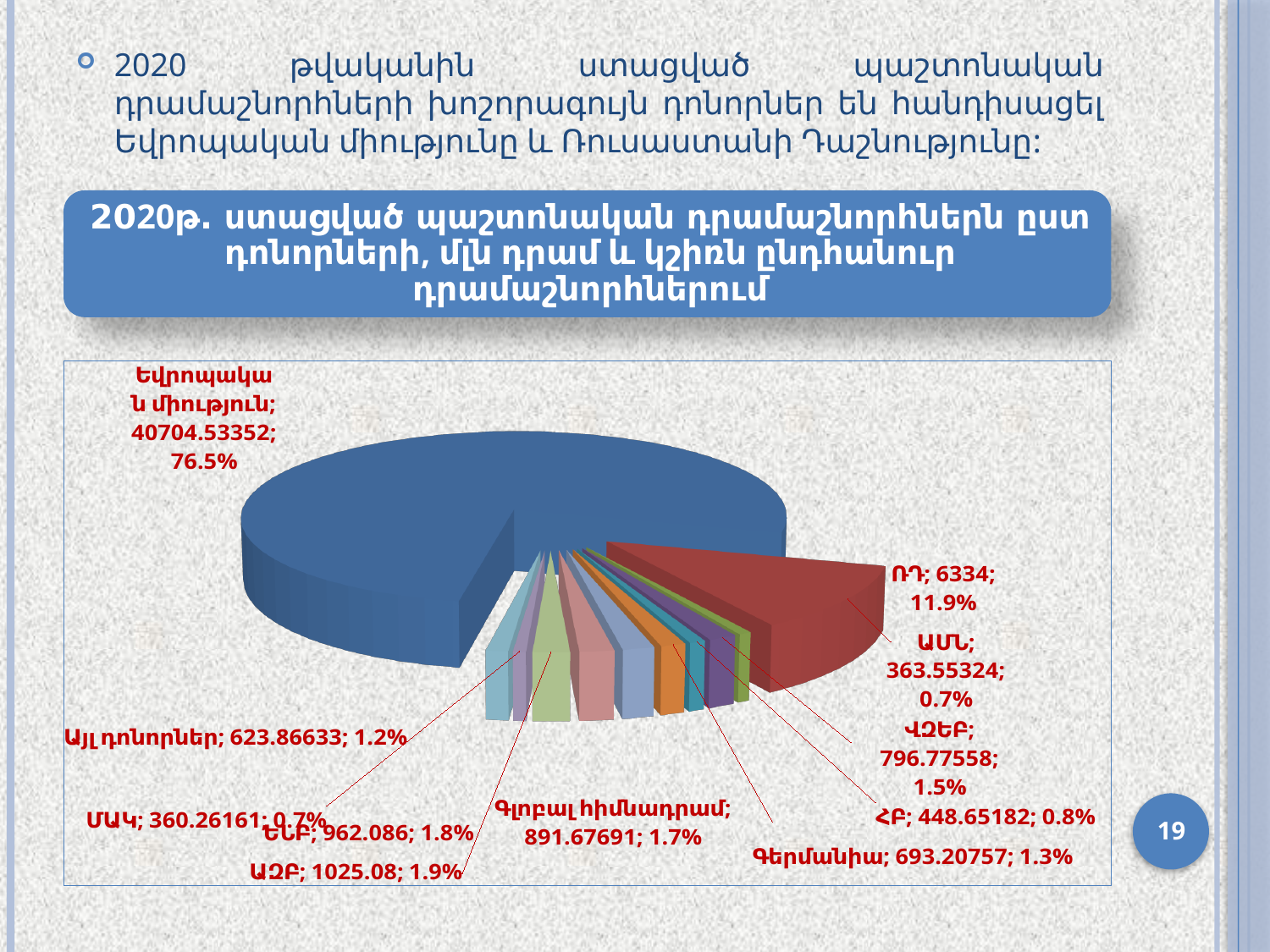
How many slices does the pie chart have? 11 What kind of chart is shown on the slide? pie chart What value is shown for Եվրոպական միություն in the pie chart? 40704.53352 Which donor has the largest slice of the pie? Եվրոպական միություն Which is larger, the value for ԱԶԲ or the value for ԵՆԲ? ԱԶԲ What share of the pie does Եվրոպական միություն hold? 76.5% What share of the pie does ՌԴ hold? 11.9% What is the difference in percentage points between the share of Եվրոպական միություն and the share of ՌԴ? 64.6% What value is shown for ՌԴ in the pie chart? 6334 What value is shown for Գերմանիա in the pie chart? 693.20757 Which donor has the smallest value in the pie chart? ՄԱԿ What colour is the slice for Եվրոպական միություն? blue